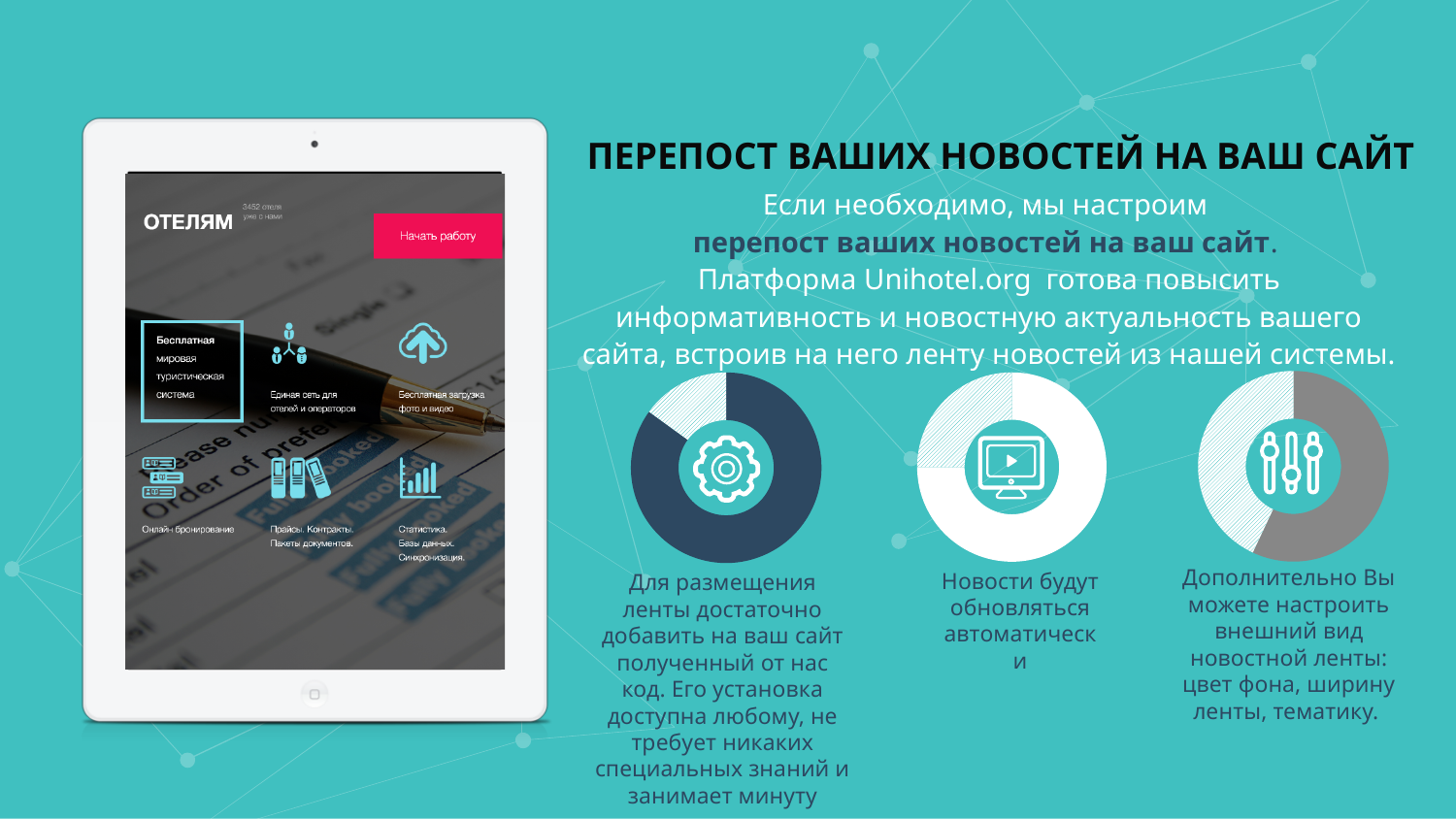
In the rightmost donut chart (with the sliders icon), which colour segment takes up the largest share of the ring? grey Do any of the three donut charts display numeric data labels or percentages? No In the leftmost donut chart (with the gear icon), which colour segment takes up the largest share of the ring? dark navy What icon is placed in the centre of the middle donut chart? a monitor with a play button What kind of chart is shown three times in the lower right part of the slide? donut (pie) chart How many donut charts are on the slide? 3